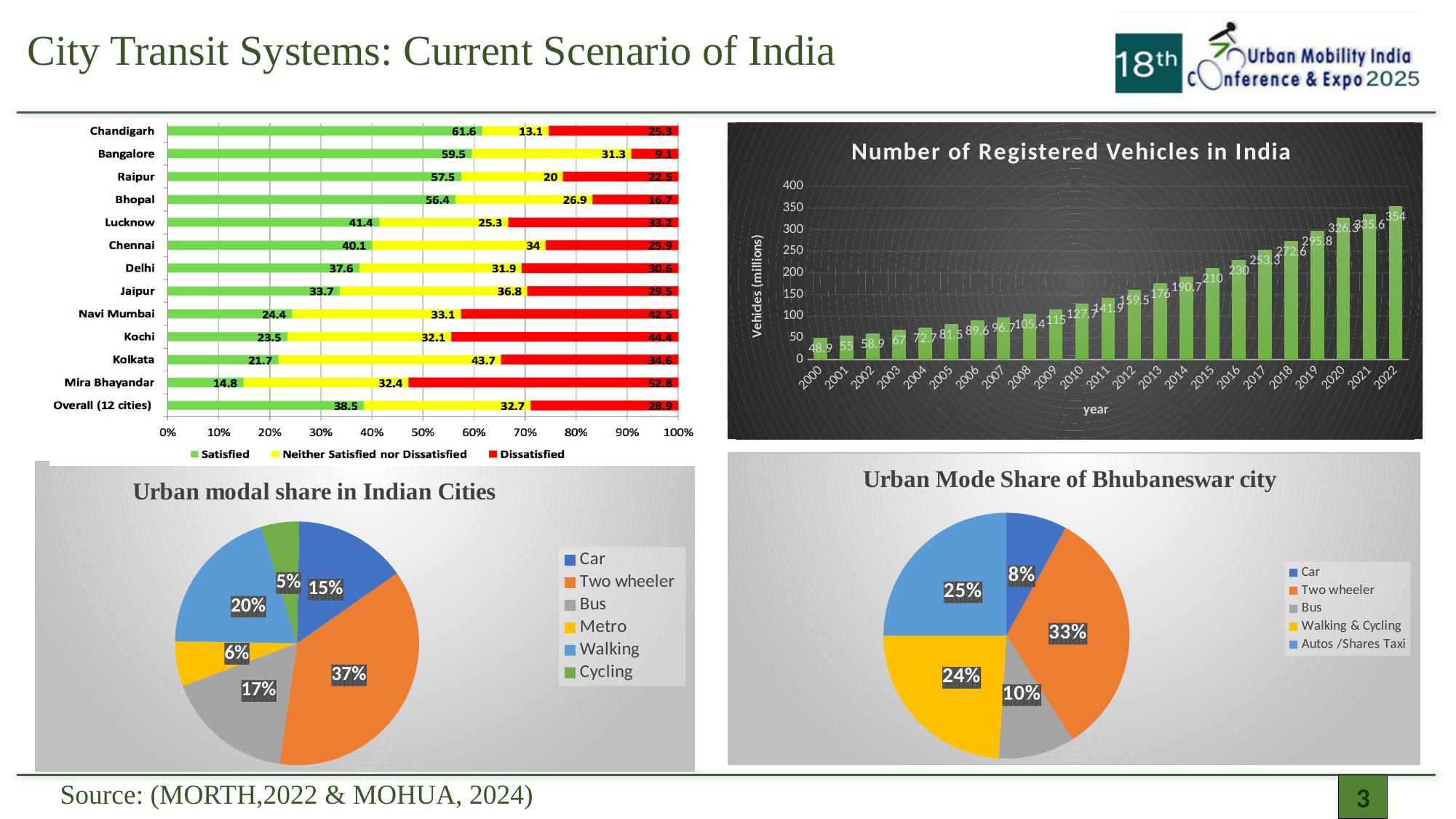
What kind of chart is 'Number of Registered Vehicles in India'? bar chart In the top-left chart, what is the Satisfied value for Chandigarh? 61.6 In the top-left chart, what is the difference between the Dissatisfied values for Kochi and Navi Mumbai? 1.9 In the 'Urban modal share in Indian Cities' pie chart, what share does Two wheeler have? 37% In the 'Number of Registered Vehicles in India' chart, what is the value for 2022? 354 In the 'Number of Registered Vehicles in India' chart, do the values rise or fall from 2000 to 2022? rise In the 'Number of Registered Vehicles in India' chart, what is the difference between the values for 2022 and 2021? 18.4 In the top-left chart, what is the Dissatisfied value for Mira Bhayandar? 52.8 In the top-left chart, how many series does the legend list? 3 In the top-left chart, which city has the highest Satisfied value? Chandigarh In the 'Urban Mode Share of Bhubaneswar city' pie chart, what share does Walking & Cycling have? 24% In the 'Number of Registered Vehicles in India' chart, what is the value for 2000? 48.9